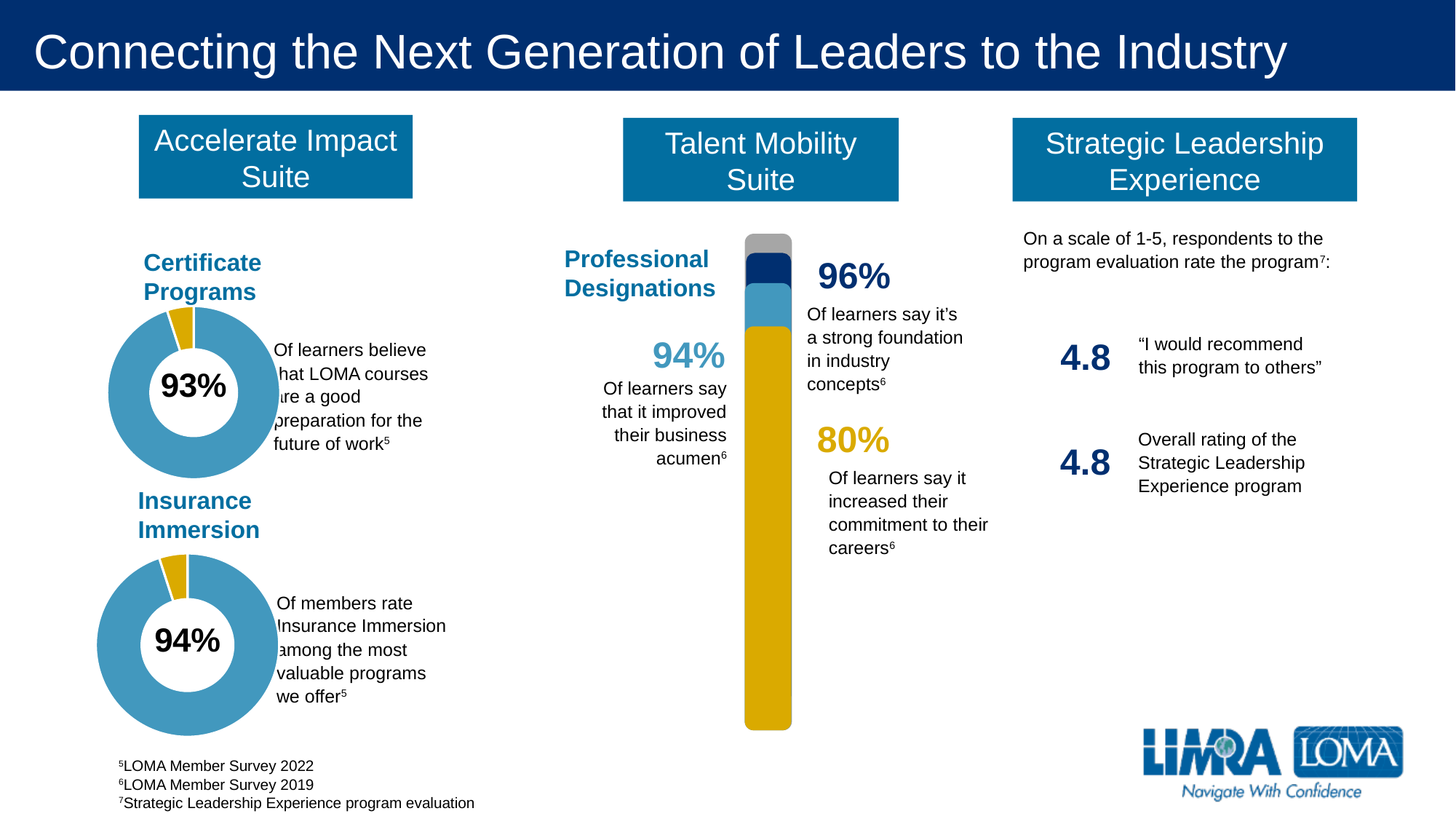
Which donut chart shows the larger percentage, Certificate Programs or Insurance Immersion? Insurance Immersion In the Professional Designations chart, what percentage of learners say it improved their business acumen? 94% In the Professional Designations chart, what percentage of learners say it increased their commitment to their careers? 80% How many donut charts are shown under the Accelerate Impact Suite? 2 In the Professional Designations chart under the Talent Mobility Suite, what percentage of learners say it's a strong foundation in industry concepts? 96% Among the three Professional Designations percentages, which statement has the lowest value? Increased their commitment to their careers (80%) What is the difference between the Insurance Immersion percentage (94%) and the Certificate Programs percentage (93%)? 1% In the Insurance Immersion donut chart, what percentage of members rate Insurance Immersion among the most valuable programs offered? 94% What colour is the largest segment of the Professional Designations stacked bar? Gold/yellow In the Certificate Programs donut chart, what percentage of learners believe that LOMA courses are a good preparation for the future of work? 93% What kind of chart is used for the Certificate Programs figure under the Accelerate Impact Suite? Donut (pie) chart